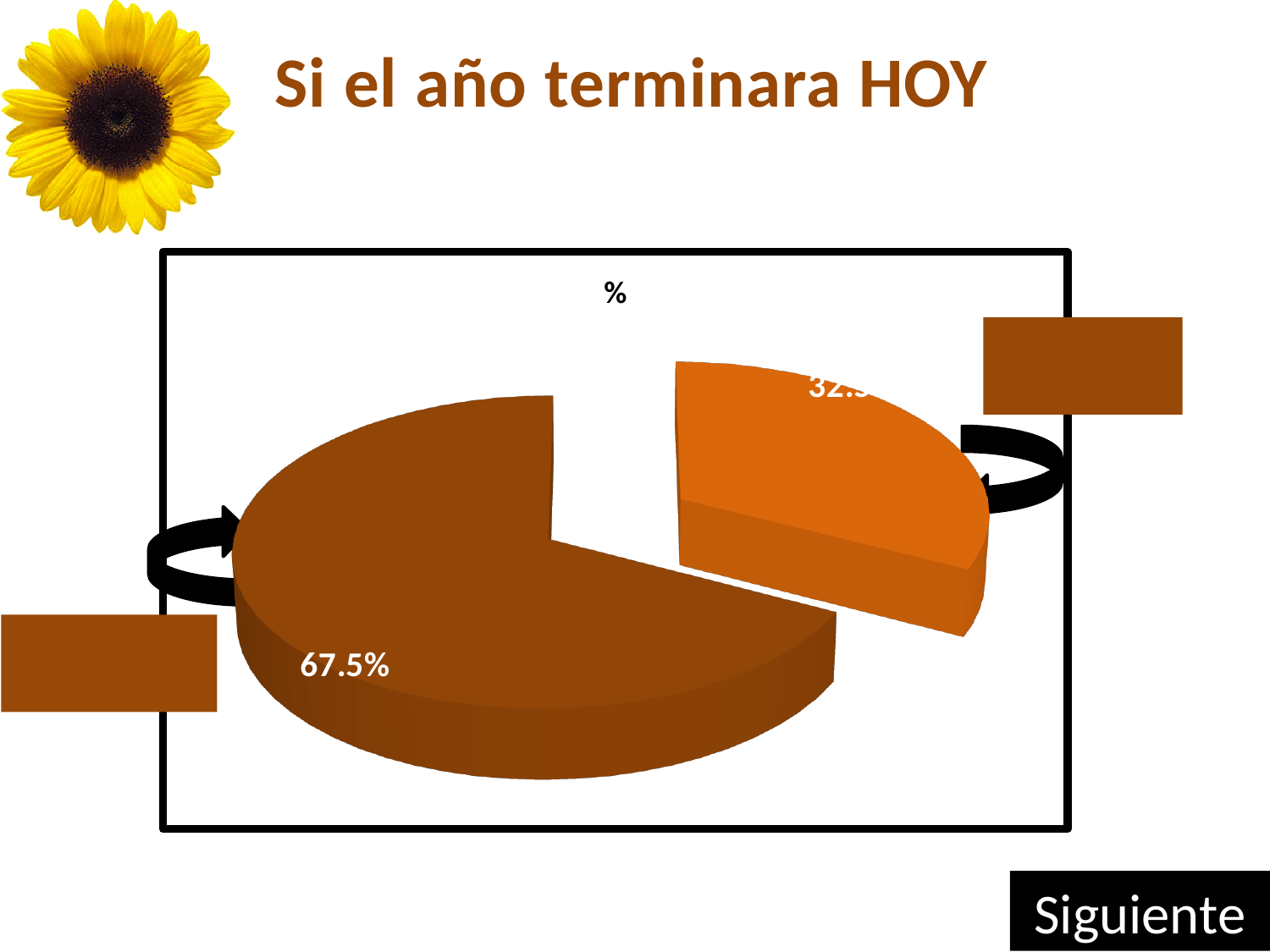
What is the title of the chart? % Which slice is larger, the dark brown slice or the orange slice? the dark brown slice What share of the pie does the orange slice represent? 32.5% Is the value of the orange slice greater or less than 50%? less What is the difference between the two slices of the pie chart? 35% How many slices does the pie chart have? 2 What colour is the slice labelled 67.5%? dark brown Is the value of the dark brown slice greater or less than 50%? greater What percentage is shown on the largest slice of the pie chart? 67.5% What kind of chart is shown on the slide? pie chart What share of the pie does the dark brown slice represent? 67.5%